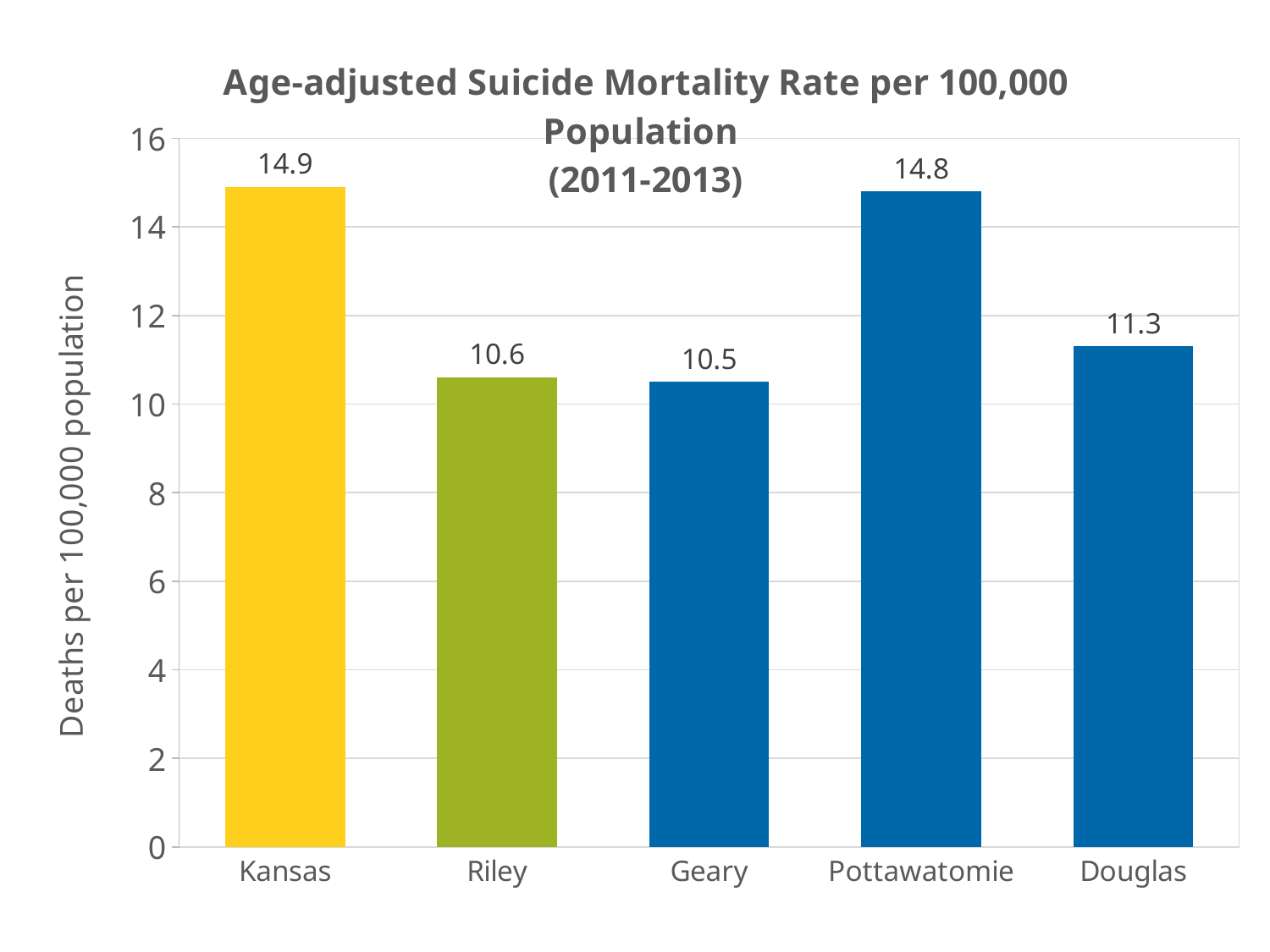
What is the age-adjusted suicide mortality rate for Kansas? 14.9 Which category has the highest value? Kansas How many categories are shown on the x axis? 5 What is the value shown for Riley? 10.6 What kind of chart is shown on the slide? bar chart What is the difference between the values for Kansas and Douglas? 3.6 Is the value for Douglas greater or less than 12? less Which is larger, the value for Pottawatomie or the value for Riley? Pottawatomie Which category has the lowest value? Geary What is the difference between the values for Pottawatomie and Geary? 4.3 What is the value shown for Douglas? 11.3 What is the label of the vertical axis? Deaths per 100,000 population